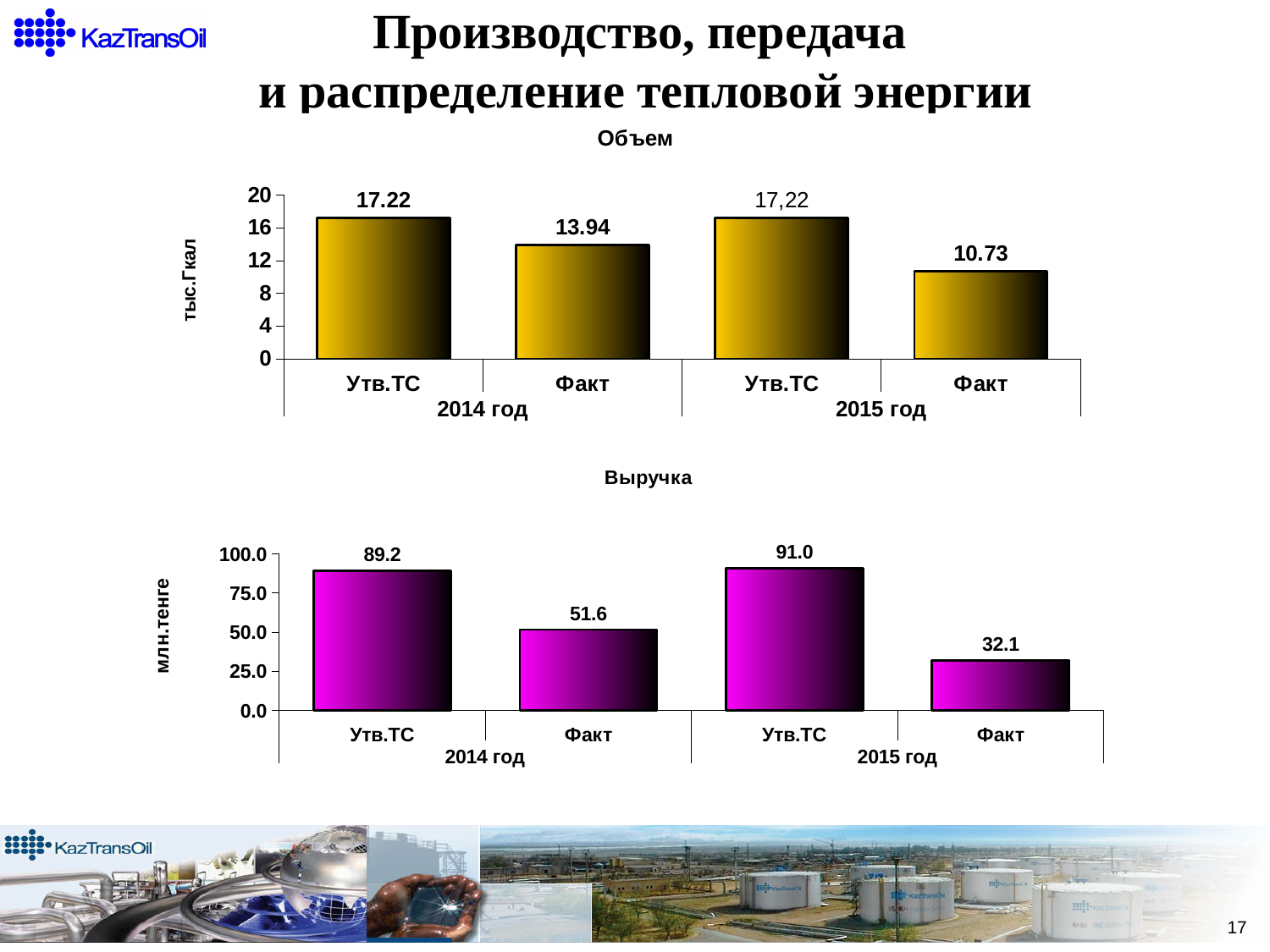
In the "Объем" chart, which bar has the lowest value? Факт, 2015 год In the "Выручка" chart, what is the difference between Утв.ТС and Факт in 2015 год? 58.9 In the "Выручка" chart, what is the value for Утв.ТС in 2015 год? 91.0 In the "Выручка" chart, what is the value for Факт in 2014 год? 51.6 In the "Объем" chart, what is the value for Факт in 2015 год? 10.73 In the "Выручка" chart, which bar has the highest value? Утв.ТС, 2015 год In the "Объем" chart, what is the difference between Утв.ТС and Факт in 2014 год? 3.28 In the "Объем" chart, how many bars are plotted? 4 In the "Выручка" chart, which is larger: Факт in 2014 год or Факт in 2015 год? Факт in 2014 год In the "Объем" chart, what is the value for Утв.ТС in 2014 год? 17.22 In the "Объем" chart, what is the value for Факт in 2014 год? 13.94 What type of chart is the "Выручка" chart? Bar chart